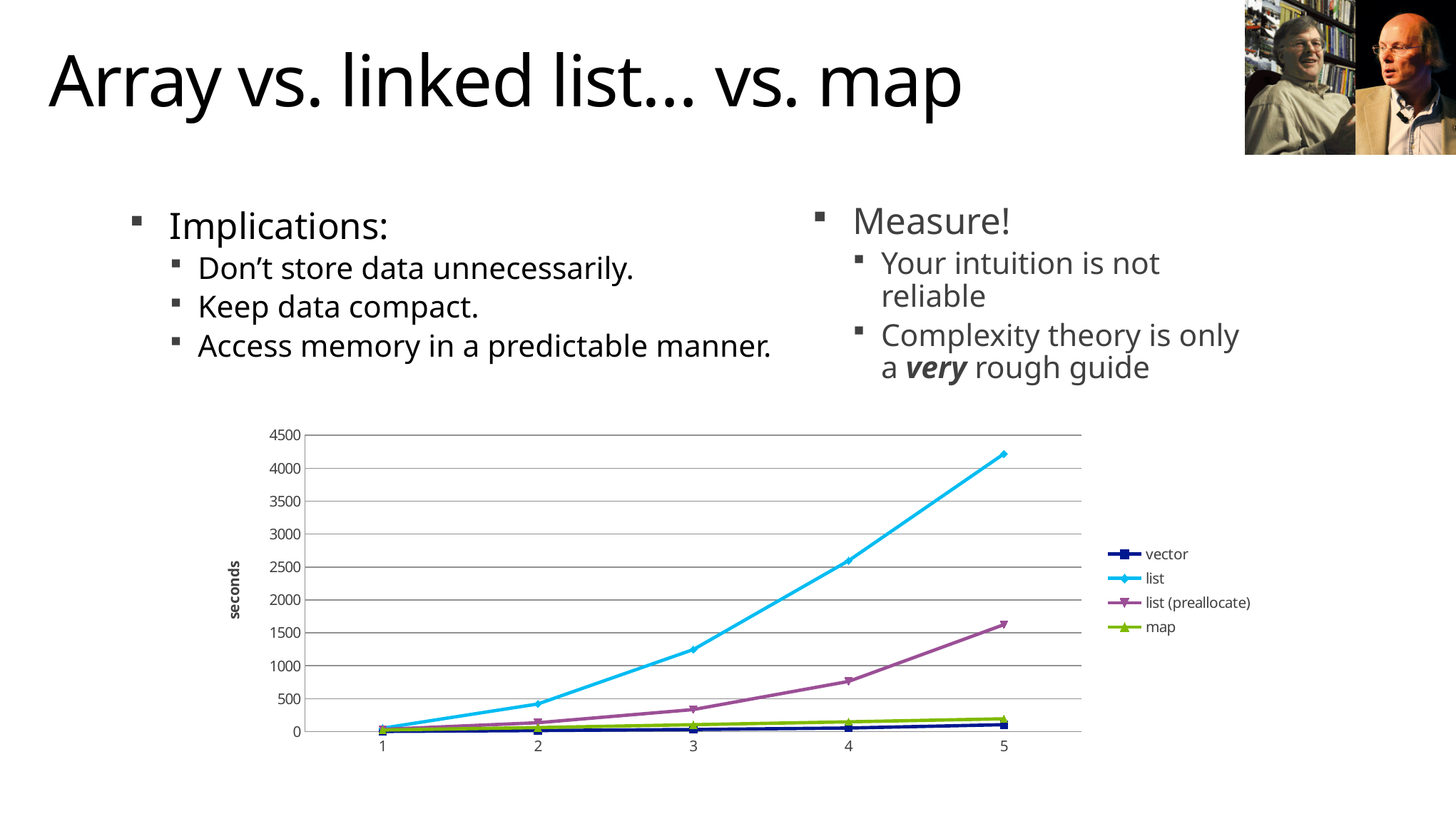
Does the list series rise or fall as x increases from 1 to 5? rise What is the label on the chart's y axis? seconds How many series does the chart's legend list? 4 Which series has the lowest value at x = 5? vector At x = 4, which is larger: list or list (preallocate)? list Which series has the highest value at x = 5? list How many points are there along the x axis of the chart? 5 Is the value for list (preallocate) at x = 4 greater or less than 1000? less Is the value for list at x = 5 greater or less than 4000? greater Is the value for list (preallocate) at x = 5 greater or less than 1500? greater What kind of chart is shown on the slide? line chart